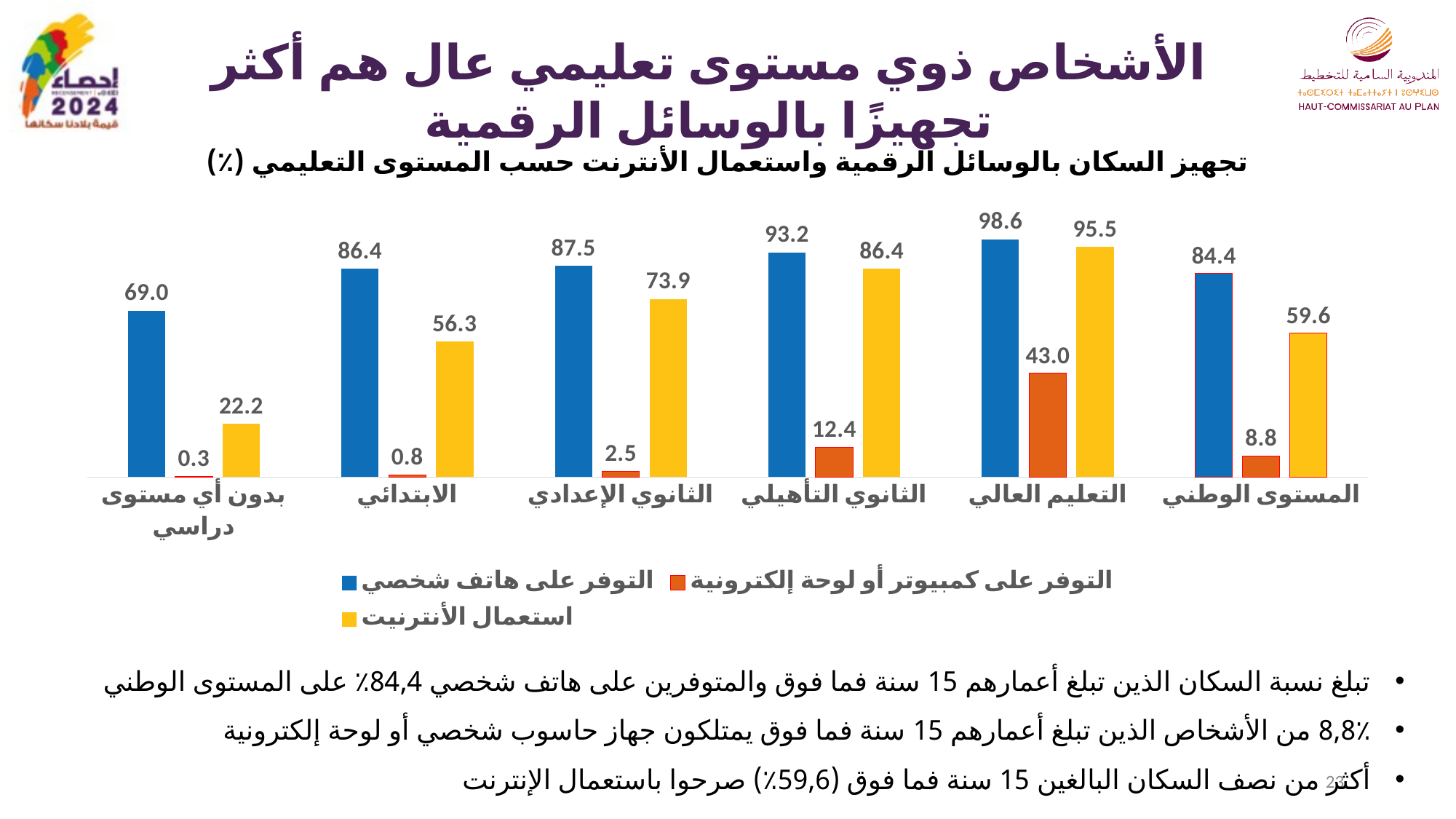
What is the value for 'التوفر على كمبيوتر أو لوحة إلكترونية' in the 'المستوى الوطني' category? 8.8 What is the value for 'استعمال الأنترنيت' in the 'الابتدائي' category? 56.3 Do the 'التوفر على كمبيوتر أو لوحة إلكترونية' values rise or fall from 'بدون أي مستوى دراسي' to 'التعليم العالي'? Rise How many categories are shown on the x axis? 6 What is the difference between the 'استعمال الأنترنيت' values for 'التعليم العالي' and 'المستوى الوطني'? 35.9 Which colour represents 'استعمال الأنترنيت' in the chart? Yellow Which is larger: the 'التوفر على هاتف شخصي' value for 'الثانوي الإعدادي' or for 'الابتدائي'? الثانوي الإعدادي What kind of chart is shown on the slide? Bar chart How many series does the legend list? 3 Which category has the lowest value for 'استعمال الأنترنيت'? بدون أي مستوى دراسي Which category has the highest value for 'التوفر على كمبيوتر أو لوحة إلكترونية'? التعليم العالي What is the value for 'التوفر على هاتف شخصي' in the 'التعليم العالي' category? 98.6